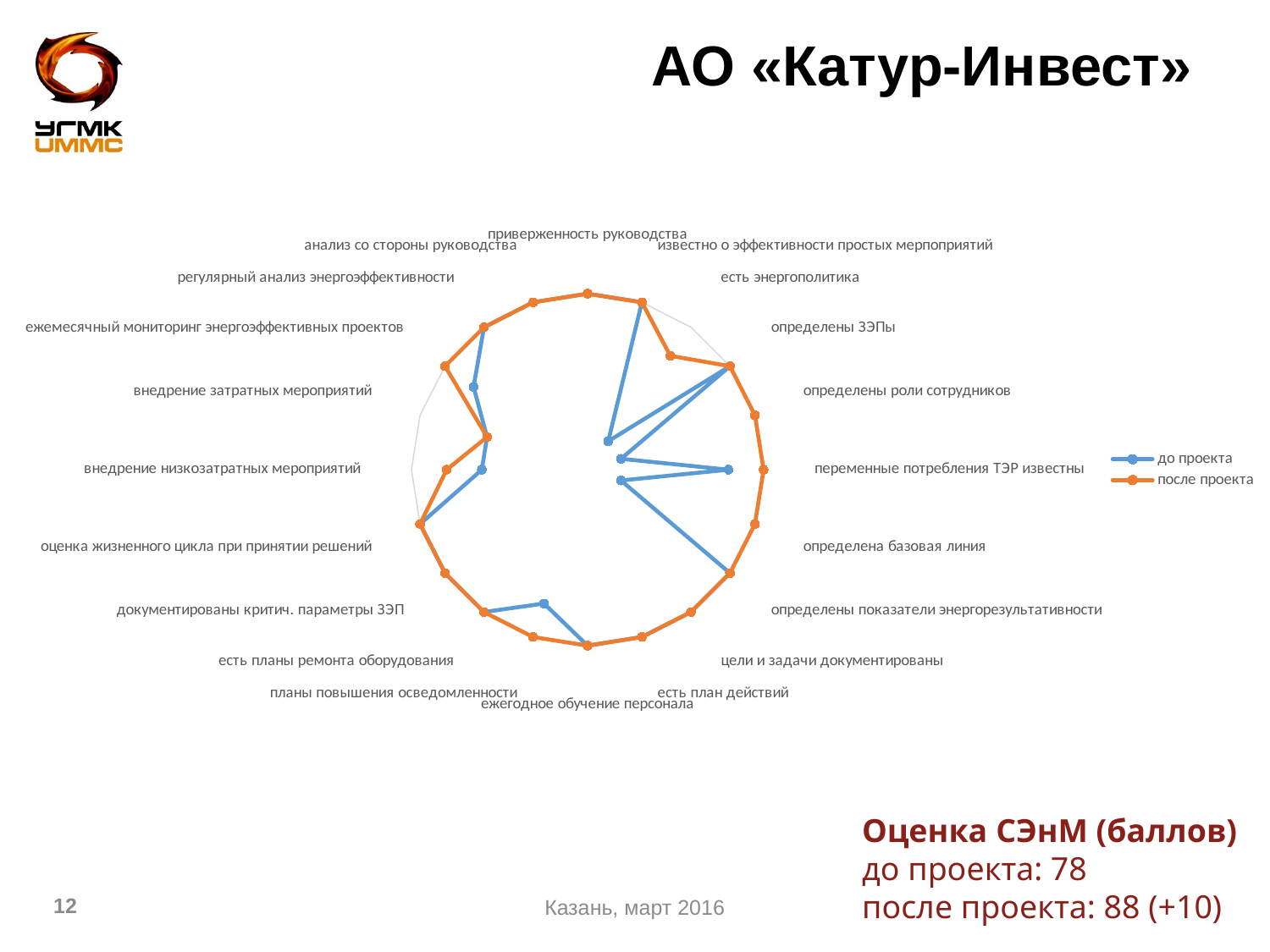
For 'есть энергополитика', is the value for 'до проекта' larger or smaller than the value for 'после проекта'? smaller Which series is drawn in orange on the chart? после проекта How many categories (axes) does the radar chart have? 20 For 'ежемесячный мониторинг энергоэффективных проектов', which series has the larger value: 'до проекта' or 'после проекта'? после проекта For 'определена базовая линия', which series has the larger value: 'до проекта' or 'после проекта'? после проекта What are the two series named in the chart legend? до проекта, после проекта How many series does the chart legend list? 2 What kind of chart is shown on the slide? radar chart